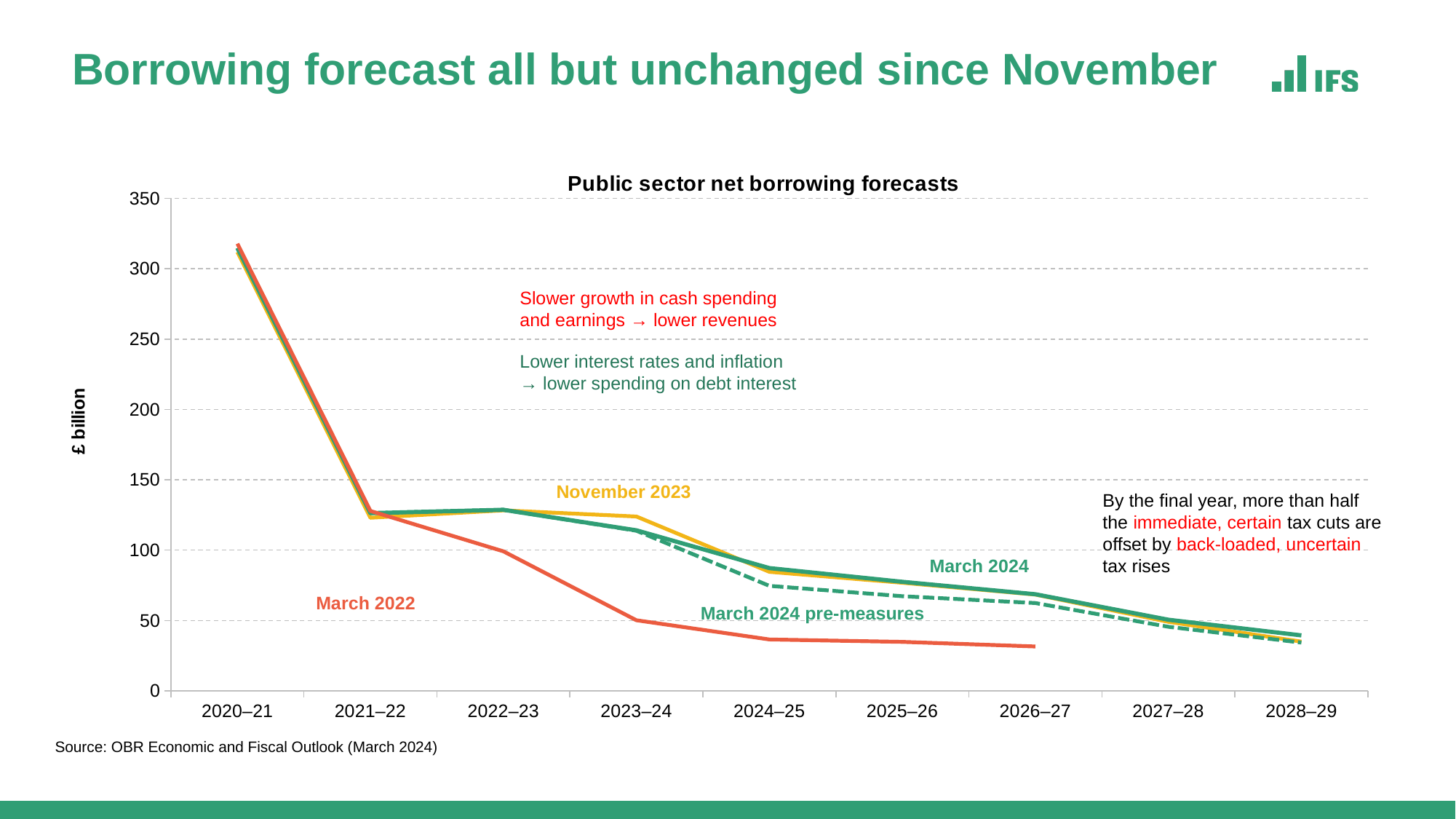
What is the title of the chart? Public sector net borrowing forecasts Is the November 2023 forecast for 2023–24 greater or less than 100? greater What is the label on the y axis of the chart? £ billion Is the March 2024 pre-measures forecast for 2024–25 greater or less than 50? greater How many forecast series are plotted on the chart? 4 In which year is the March 2022 forecast highest? 2020–21 How many fiscal years are shown on the x axis of the chart? 9 What kind of chart is shown on the slide? line chart In 2024–25, which is larger: the March 2022 forecast or the March 2024 forecast? March 2024 Is the March 2022 forecast for 2026–27 greater or less than 50? less Does the March 2022 forecast rise or fall from 2020–21 to 2026–27? fall